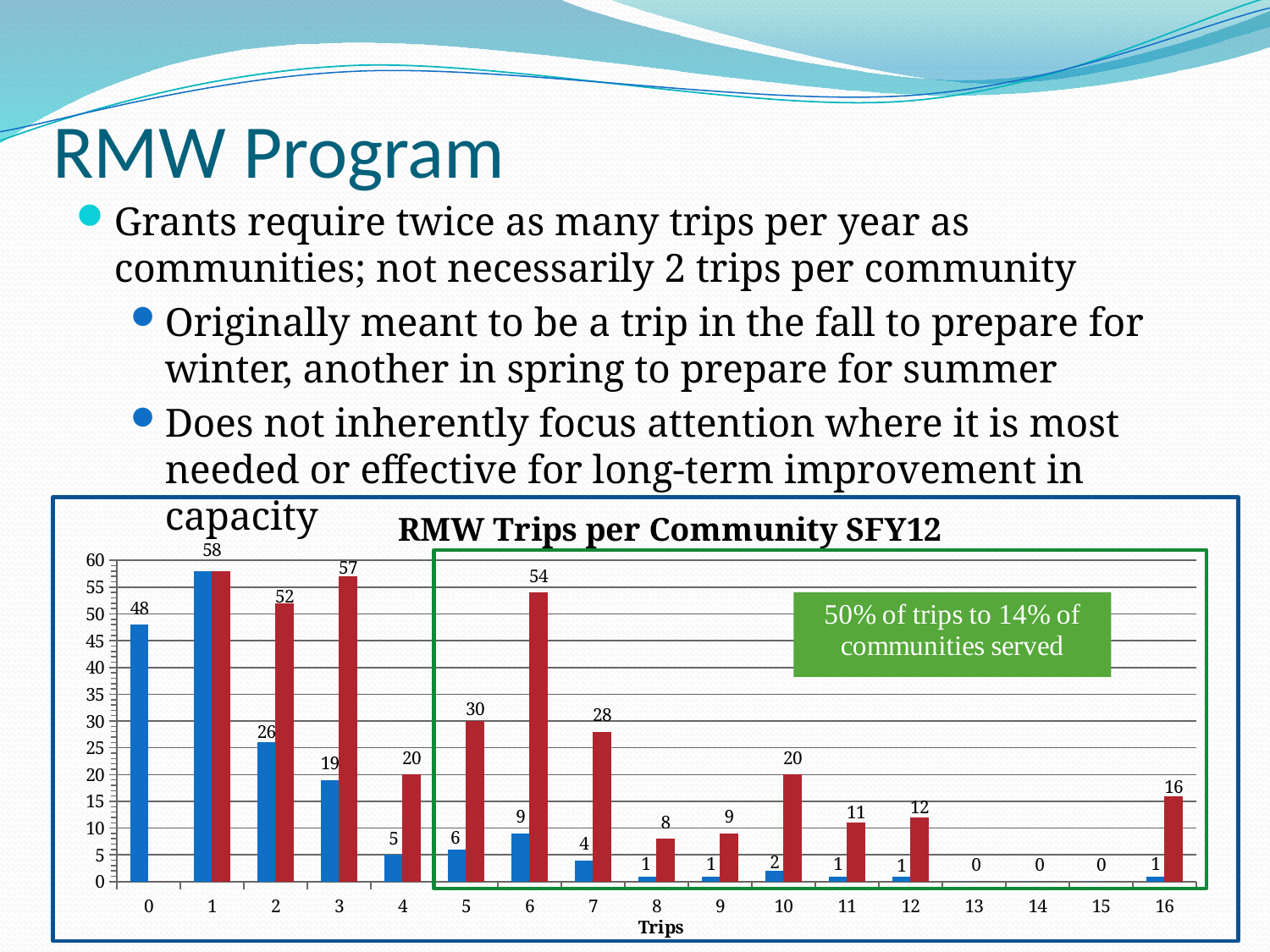
How many trip categories are shown on the x axis? 17 What is the value of the red bar at 6 trips? 54 What is the difference between the red bar at 6 trips and the red bar at 7 trips? 26 What is the value of the blue bar at 0 trips? 48 What is the value of the red bar at 3 trips? 57 What is the title of the chart? RMW Trips per Community SFY12 At which number of trips is the blue bar highest? 1 What is the value of the blue bar at 2 trips? 26 What type of chart is shown on the slide? bar chart What is the value of the red bar at 16 trips? 16 Which is larger, the red bar at 5 trips or the red bar at 4 trips? the red bar at 5 trips What does the text in the green box on the chart say? 50% of trips to 14% of communities served